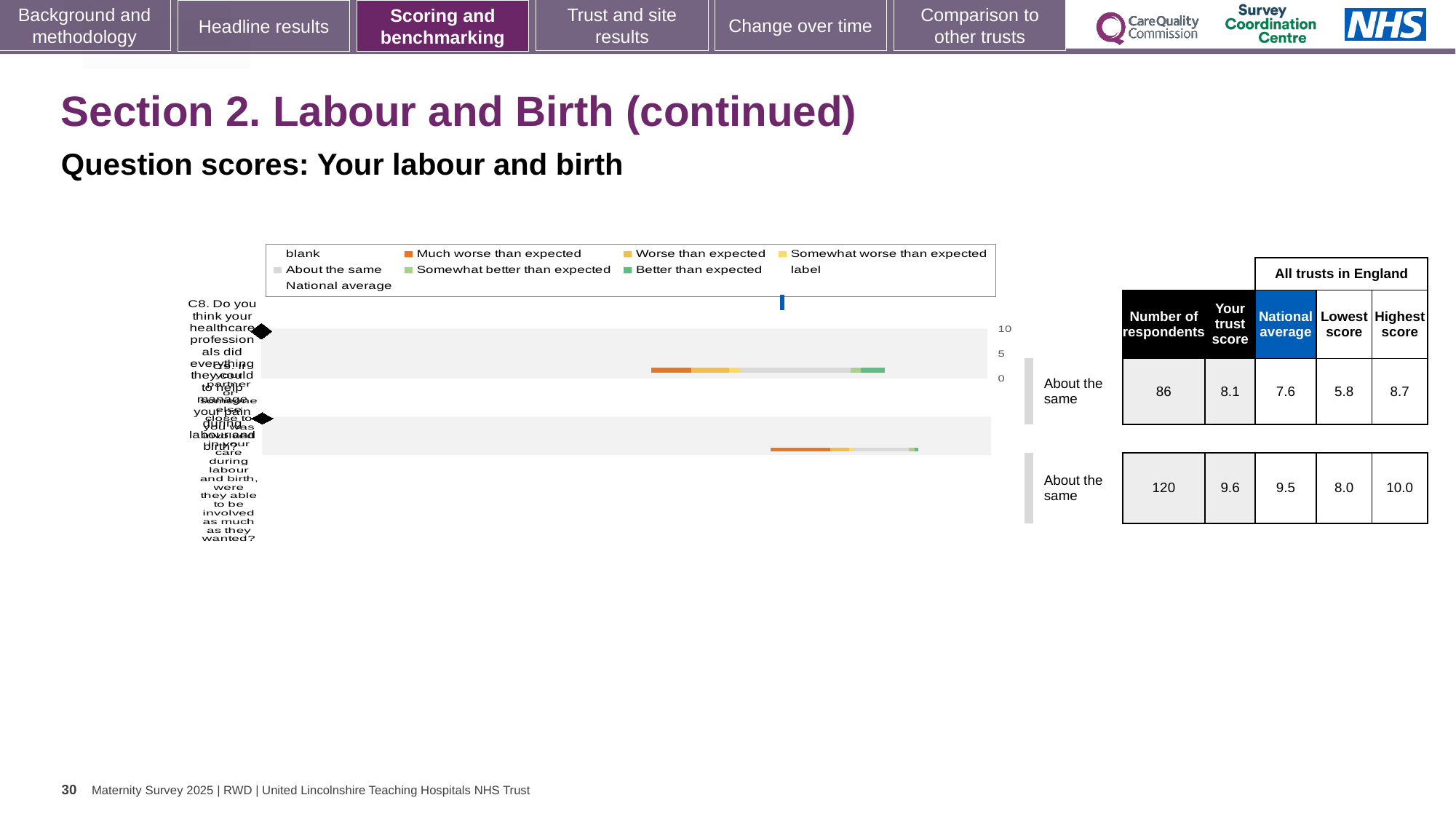
What is the difference between the trust score and the national average for the top row (C8)? 0.5 What benchmark category is given for both rows in the chart? About the same What is the trust score for the top row (C8, about managing pain during labour and birth)? 8.1 What kind of chart is shown on the slide? bar chart Which row has the higher trust score, the top row (C8) or the bottom row? the bottom row What is the highest score among all trusts in England for the bottom row question? 10.0 How many question rows (bars) does the chart show? 2 What is the national average for the top row (C8)? 7.6 How many respondents answered the top row question (C8)? 86 What is the lowest score among all trusts in England for the top row question (C8)? 5.8 What colour represents 'Much worse than expected' in the legend? orange What is the trust score for the bottom row question? 9.6